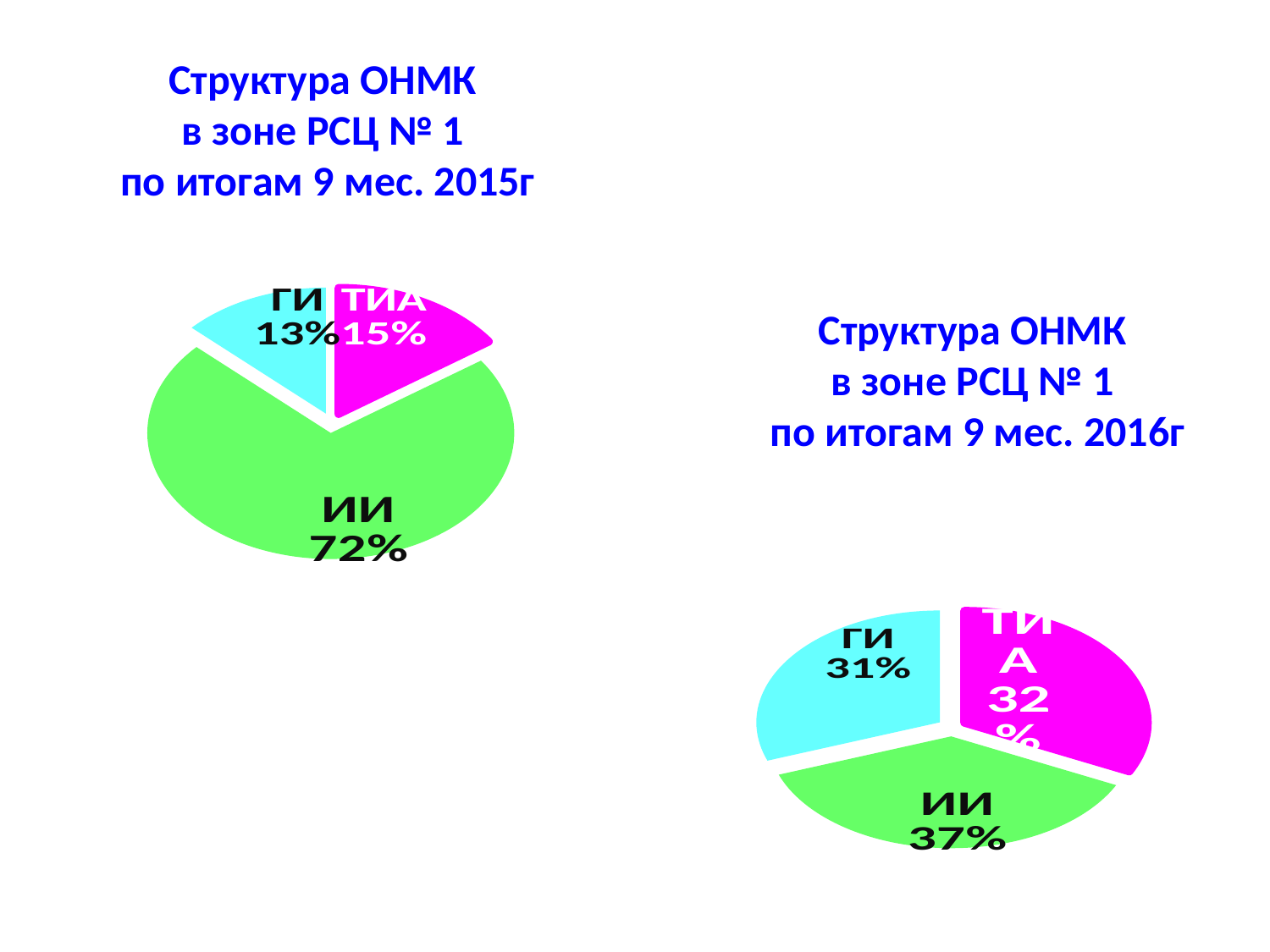
In the 2016 chart (right), what is the difference between the ИИ share and the ГИ share? 6% In the 2015 chart (left), what share does ГИ have? 13% In the 2015 chart (left), what is the difference between the ИИ share and the ТИА share? 57% In the 2015 chart (left), what share does ТИА have? 15% In the 2016 chart (right), what share does ТИА have? 32% In the 2015 chart (left), which category has the largest share? ИИ In the 2016 chart (right), what share does ГИ have? 31% What type of chart is the 2015 chart (left)? Pie chart In the 2015 chart (left), what share does ИИ have? 72% In the 2016 chart (right), what share does ИИ have? 37% How many slices does the 2016 chart (right) have? 3 In the 2015 chart (left), which category has the smallest share? ГИ